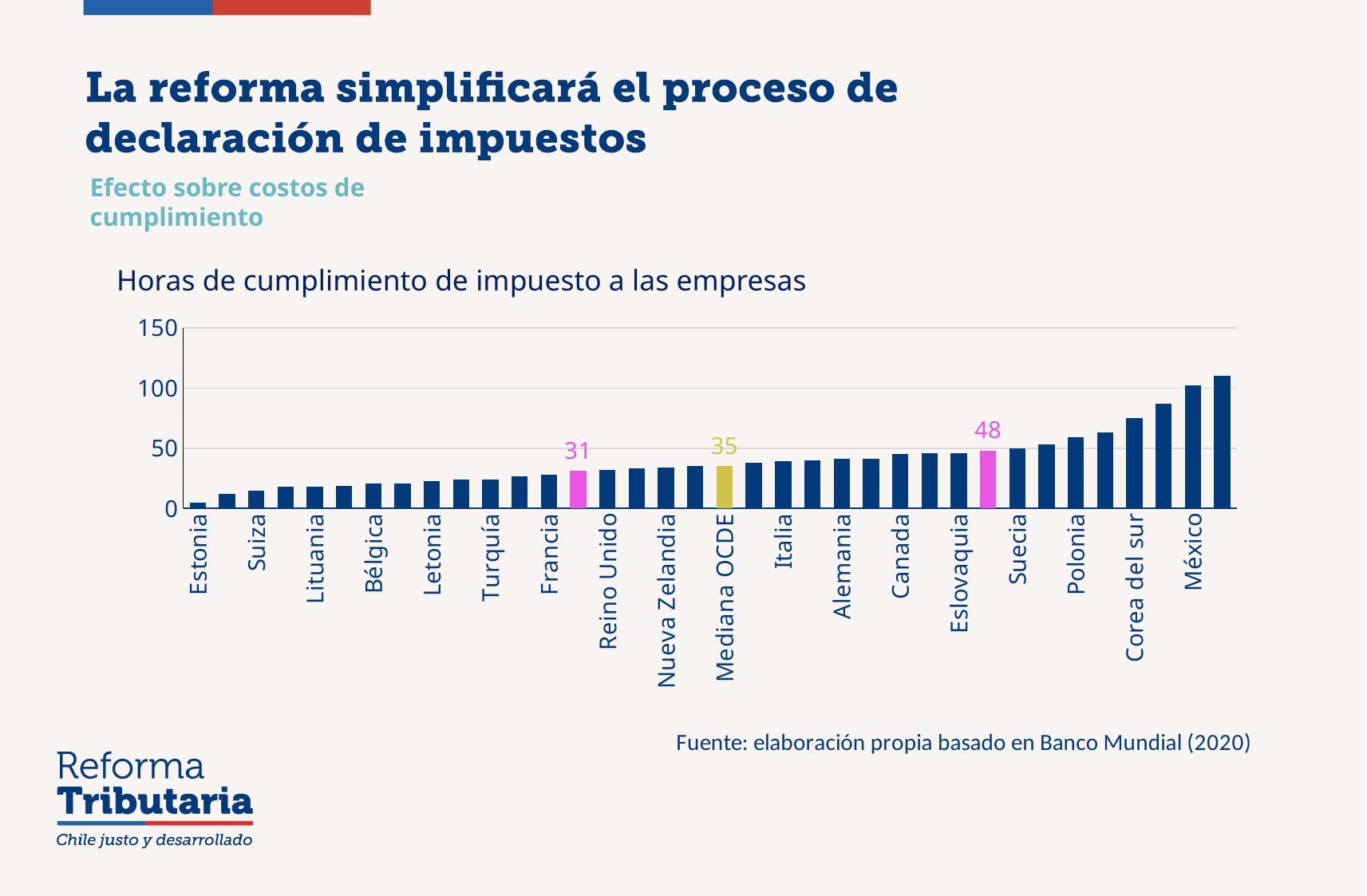
Do the values rise or fall from left to right along the x axis? rise Is the value for Corea del sur greater or less than 50? greater Is the value for Suiza greater or less than 50? less What colour is the bar for Mediana OCDE? yellow What kind of chart is shown on the slide? bar chart Which has a larger value, Polonia or Lituania? Polonia Which country has the lowest value in the chart? Estonia What is the title of the chart? Horas de cumplimiento de impuesto a las empresas What is the value shown for Mediana OCDE? 35 What is the difference between the two values labeled on the pink bars (48 and 31)? 17